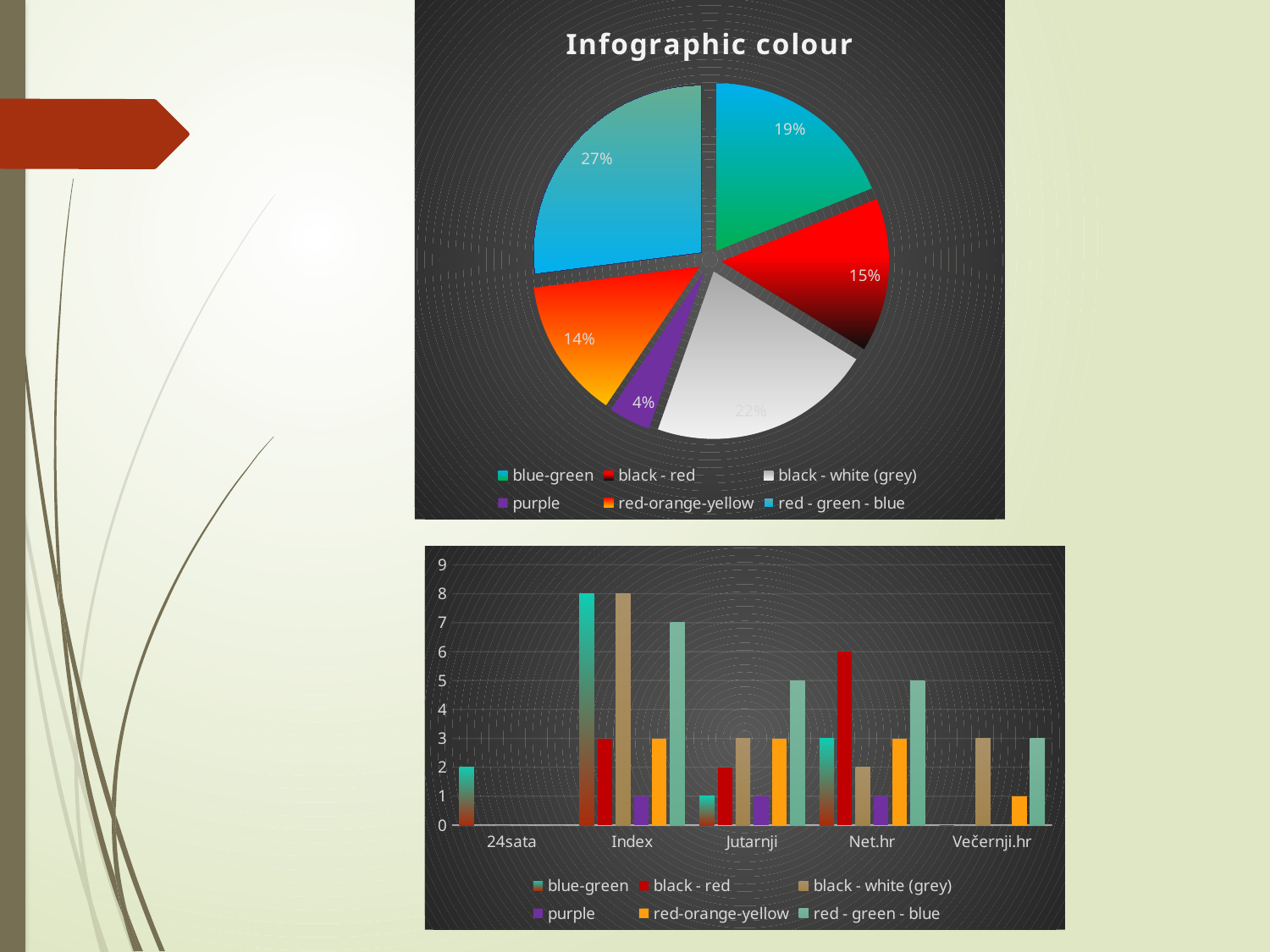
In the pie chart titled "Infographic colour", what is the difference in percentage points between the black - white (grey) slice and the black - red slice? 7 In the lower bar chart, how many series does the legend list? 6 In the lower bar chart, which is larger for Jutarnji: the red - green - blue value or the black - red value? red - green - blue In the lower bar chart, what is the value of the black - red series for Net.hr? 6 In the pie chart titled "Infographic colour", what share does the red - green - blue slice have? 27% What type of chart is the lower chart on the slide? bar chart In the pie chart titled "Infographic colour", which category has the largest slice? red - green - blue In the pie chart titled "Infographic colour", how many slices are there? 6 In the lower bar chart, how many categories are shown on the x axis? 5 In the pie chart titled "Infographic colour", which category has the smallest slice? purple In the lower bar chart, what is the value of the red - green - blue series for Index? 7 In the pie chart titled "Infographic colour", what share does the purple slice have? 4%